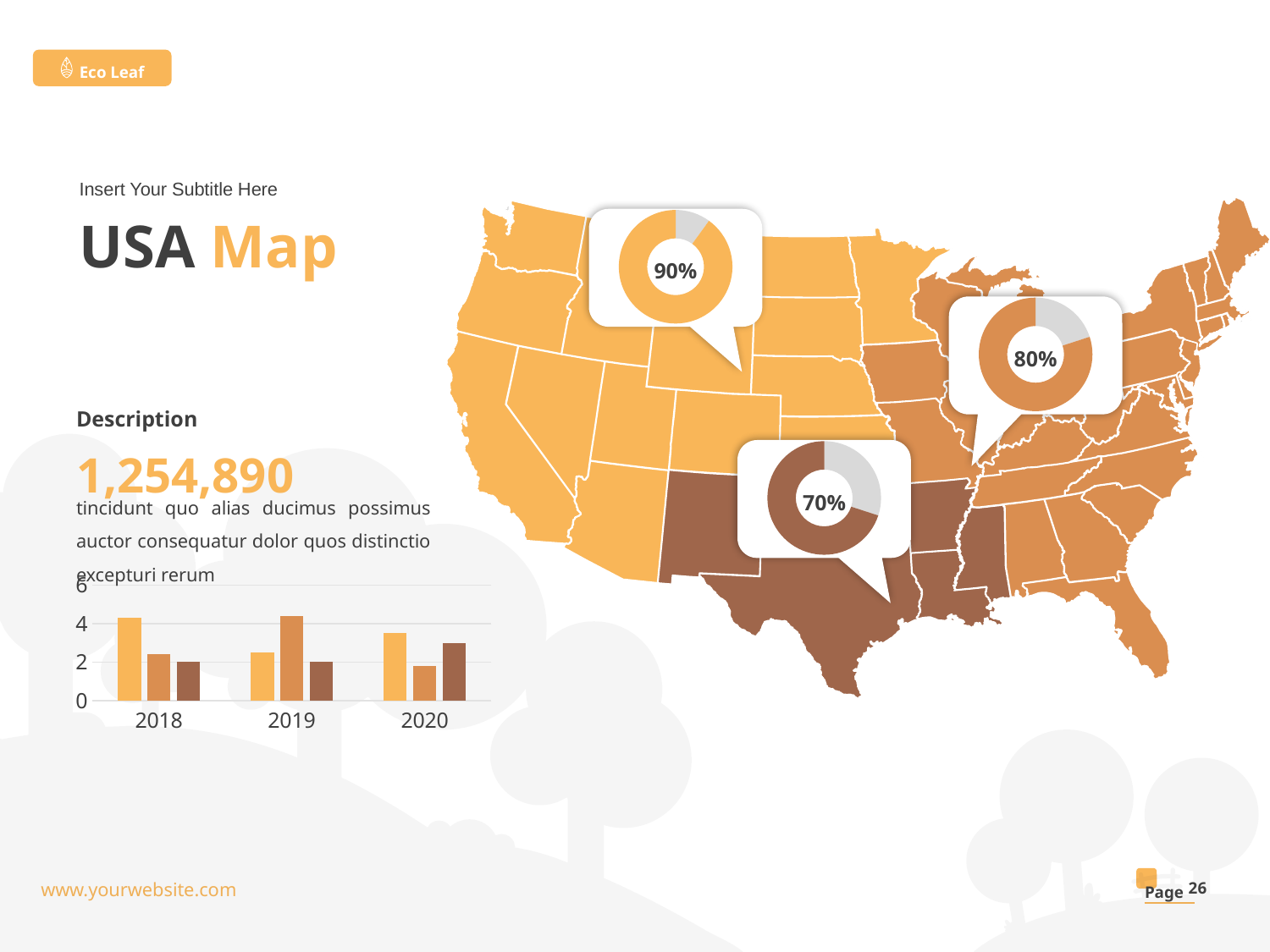
What percentage is shown in the donut chart over the Great Lakes region of the map? 80% In the bar chart at the bottom left, is the value of the first (light orange) bar for 2018 greater or less than 4? greater In the bar chart at the bottom left, how many years are shown on the x axis? 3 In the bar chart at the bottom left, which year is the first bar (leftmost, light orange) the tallest? 2018 What percentage is shown in the donut chart over Texas on the map? 70% In the bar chart at the bottom left, is the value of the middle (orange) bar for 2019 greater or less than 4? greater In the bar chart at the bottom left, which bar is taller for 2019: the first (light orange) bar or the middle (orange) bar? the middle (orange) bar In the bar chart at the bottom left, which bar is taller for 2020: the first (light orange) bar or the middle (orange) bar? the first (light orange) bar What kind of chart is shown at the bottom left of the slide? bar chart What percentage is shown in the donut chart over the northwestern states of the map? 90% What is the difference between the percentage in the donut chart over the northwestern states and the one over Texas? 20%